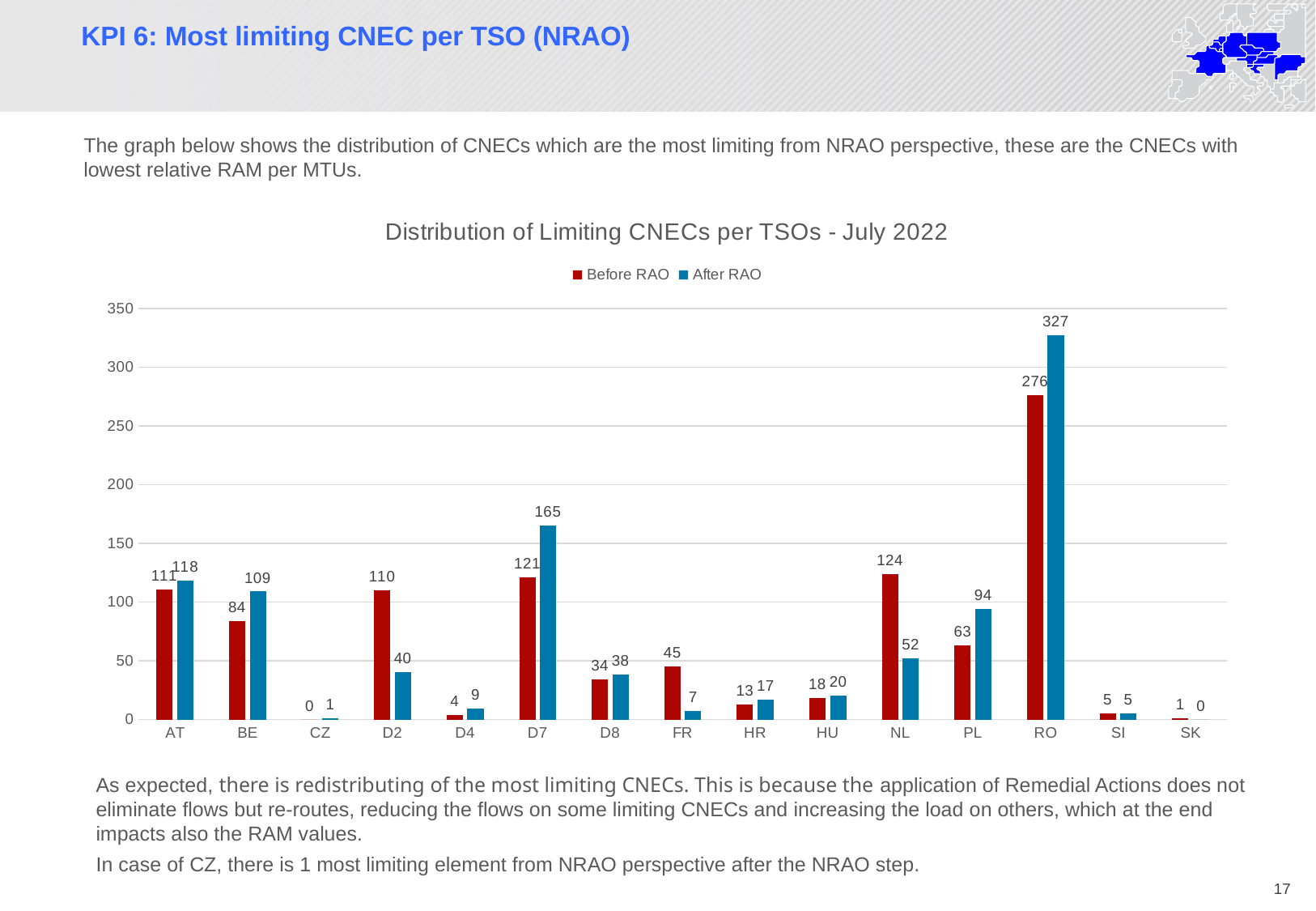
What kind of chart is shown on the slide? Bar chart Which TSO has the highest After RAO value? RO How many series does the legend list? 2 Which is larger for FR, the Before RAO value or the After RAO value? Before RAO How many TSOs are shown on the x axis? 15 What is the difference between the After RAO and Before RAO values for NL? 72 What is the After RAO value for D7? 165 Which colour represents the After RAO series? Blue What is the Before RAO value for RO? 276 What is the title of the chart? Distribution of Limiting CNECs per TSOs - July 2022 Which TSO has the lowest Before RAO value? CZ What is the After RAO value for PL? 94